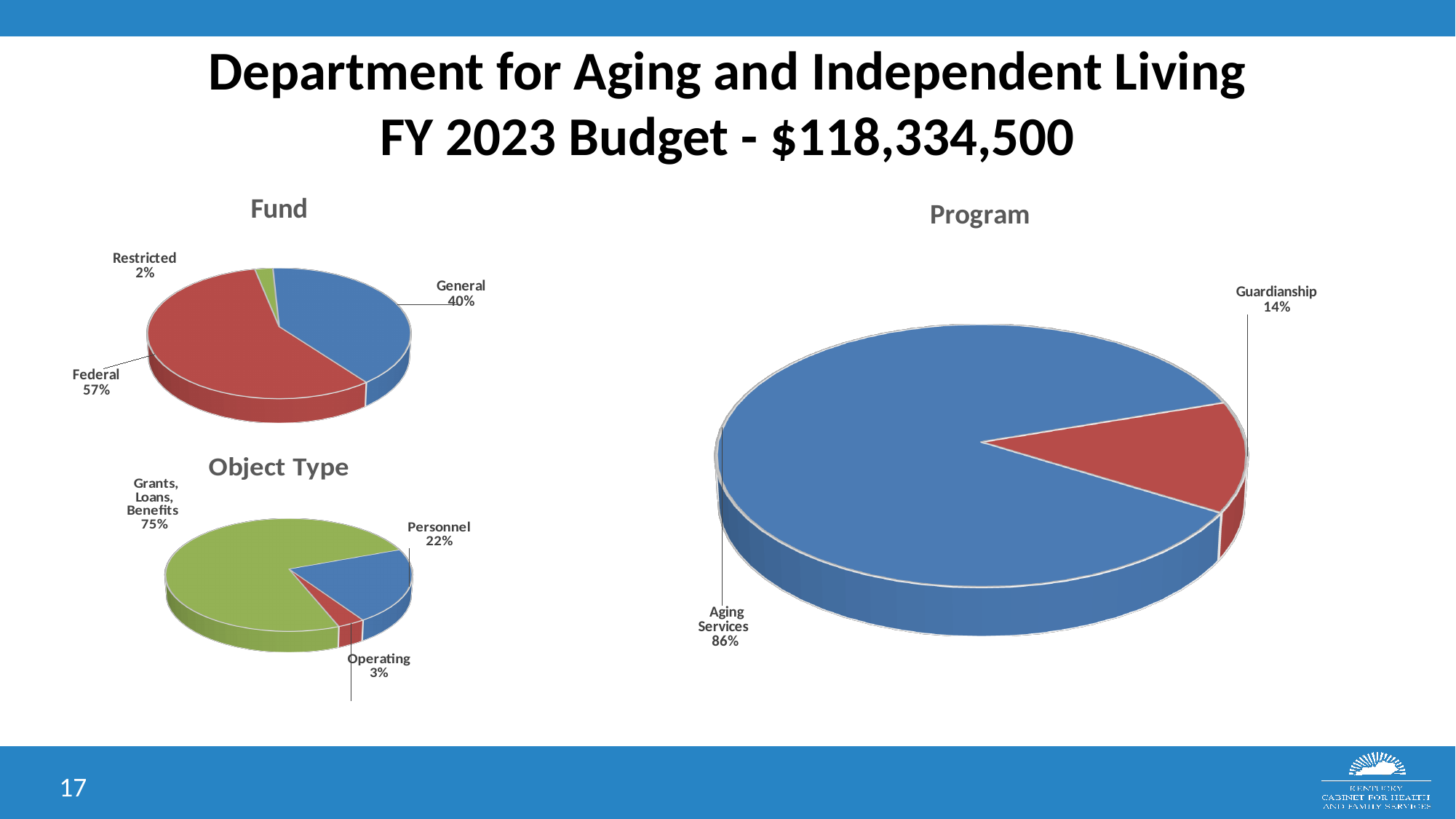
In the Fund chart, what share of the budget comes from Federal funds? 57% In the Object Type chart, which object type has the largest share? Grants, Loans, Benefits In the Fund chart, what percentage is labelled General? 40% How many slices does the Fund pie chart have? 3 In the Program chart, what is the difference in percentage points between Aging Services and Guardianship? 72 In the Fund chart, which fund source has the smallest share? Restricted In the Object Type chart, what percentage is Operating? 3% In the Object Type chart, which is larger, Personnel or Operating? Personnel In the Fund chart, what is the difference in percentage points between Federal and General? 17 In the Object Type chart, what share is Grants, Loans, Benefits? 75% In the Program chart, what share is Aging Services? 86% What kind of chart is the Program chart? Pie chart